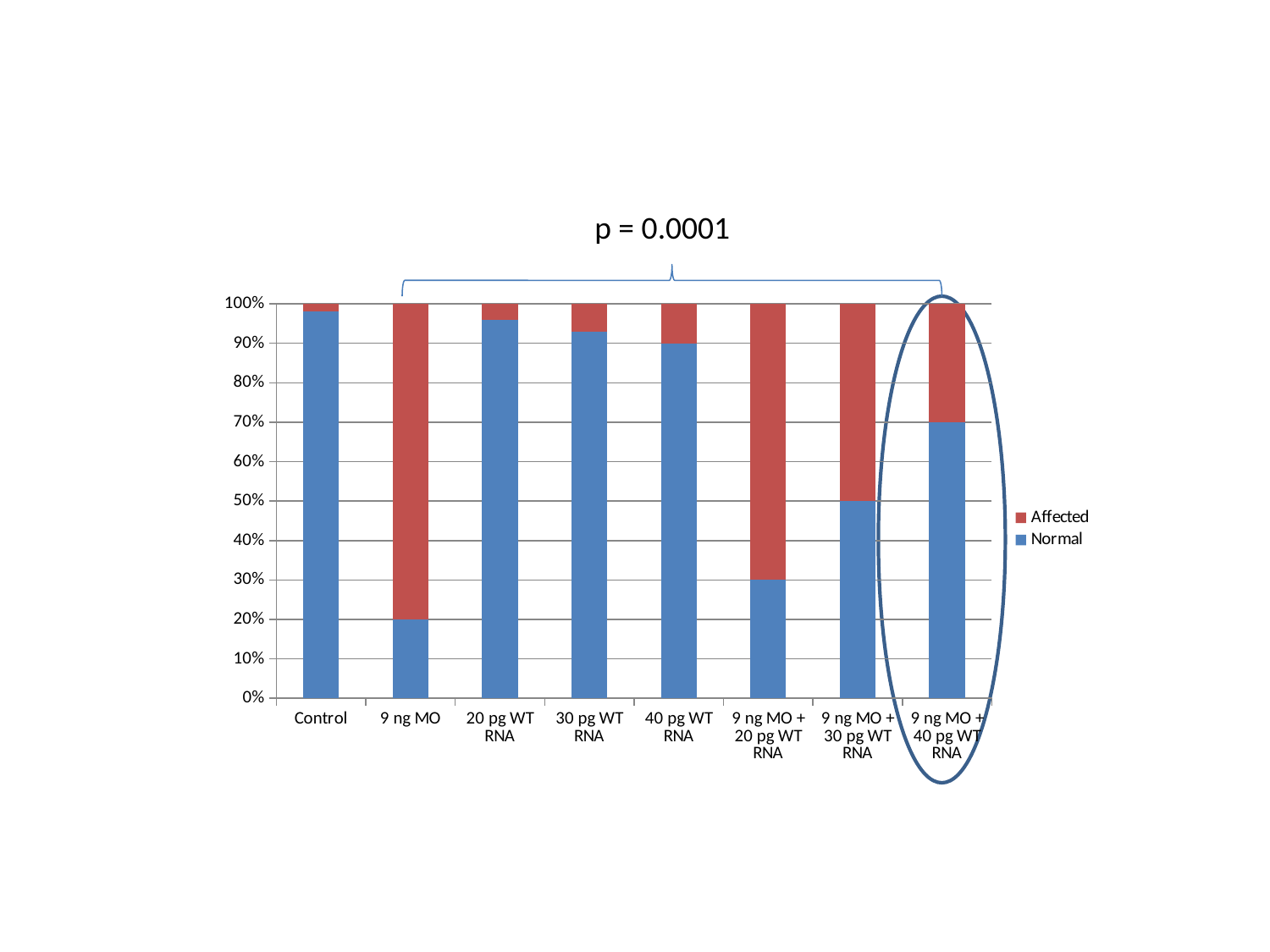
What is the Normal percentage for the 9 ng MO + 30 pg WT RNA bar? 50% Is the Normal percentage for Control greater or less than 90%? greater What is the Normal percentage for the 9 ng MO + 40 pg WT RNA bar? 70% How many series does the chart's legend list? 2 What kind of chart is shown on the slide? Stacked bar chart Which category has the lowest Normal percentage? 9 ng MO How many categories are shown along the x axis of the chart? 8 Which has a larger Normal percentage: 9 ng MO + 20 pg WT RNA or 9 ng MO + 30 pg WT RNA? 9 ng MO + 30 pg WT RNA What is the Normal percentage for the 9 ng MO bar? 20% What p value is annotated above the chart? p = 0.0001 Which category has the highest Affected percentage? 9 ng MO What is the difference in Normal percentage between the 9 ng MO + 40 pg WT RNA bar and the 9 ng MO bar? 50%